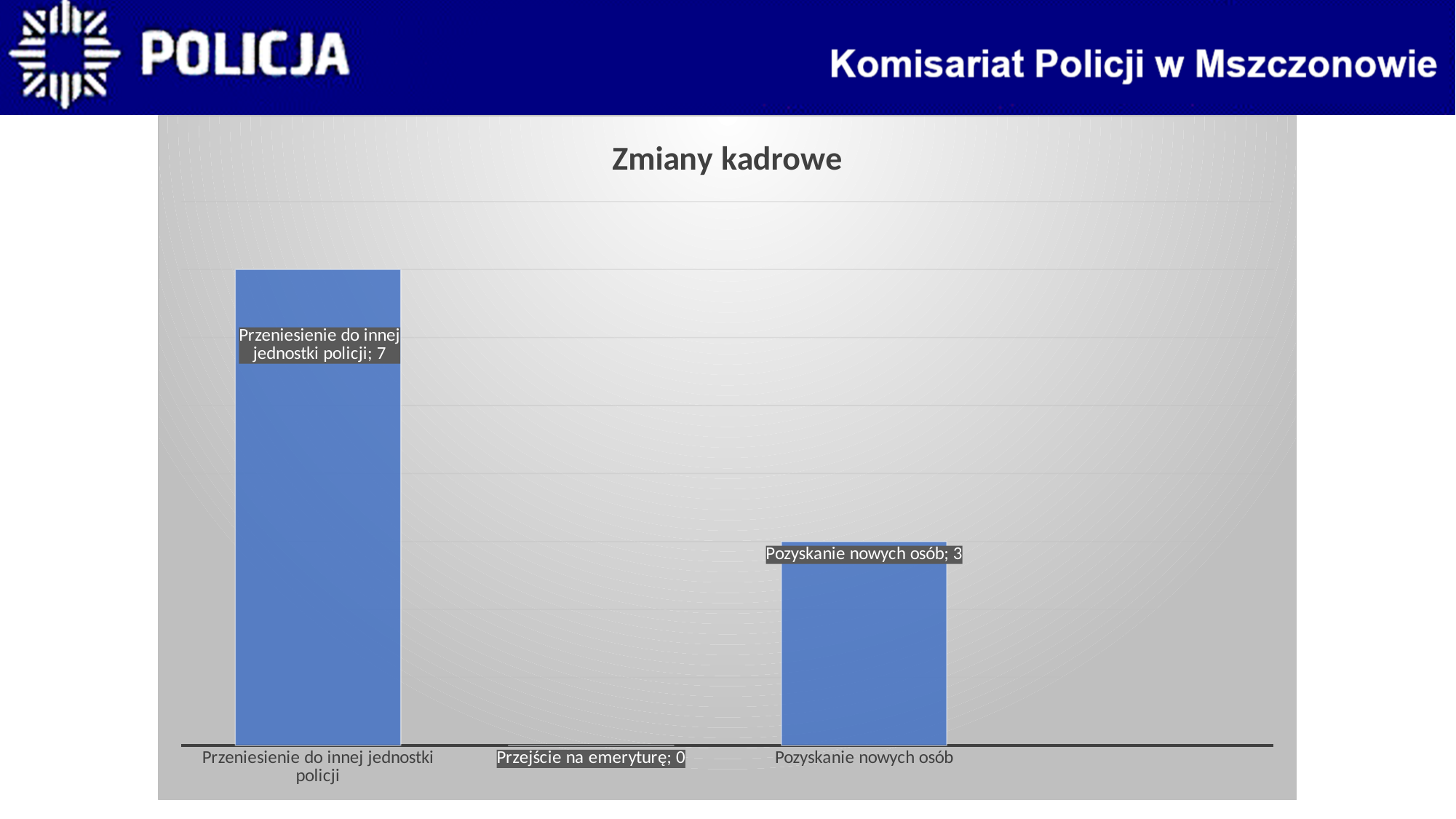
What is the difference between the values for 'Przeniesienie do innej jednostki policji' and 'Pozyskanie nowych osób'? 4 What is the value for 'Przeniesienie do innej jednostki policji'? 7 Which is larger: the value for 'Pozyskanie nowych osób' or the value for 'Przejście na emeryturę'? Pozyskanie nowych osób Which category has the highest value? Przeniesienie do innej jednostki policji Which category has the lowest value? Przejście na emeryturę What is the title of the chart? Zmiany kadrowe How many categories are shown in the chart? 3 What is the value for 'Przejście na emeryturę'? 0 What kind of chart is shown on the slide? Bar chart What colour are the bars in the chart? Blue What is the value for 'Pozyskanie nowych osób'? 3